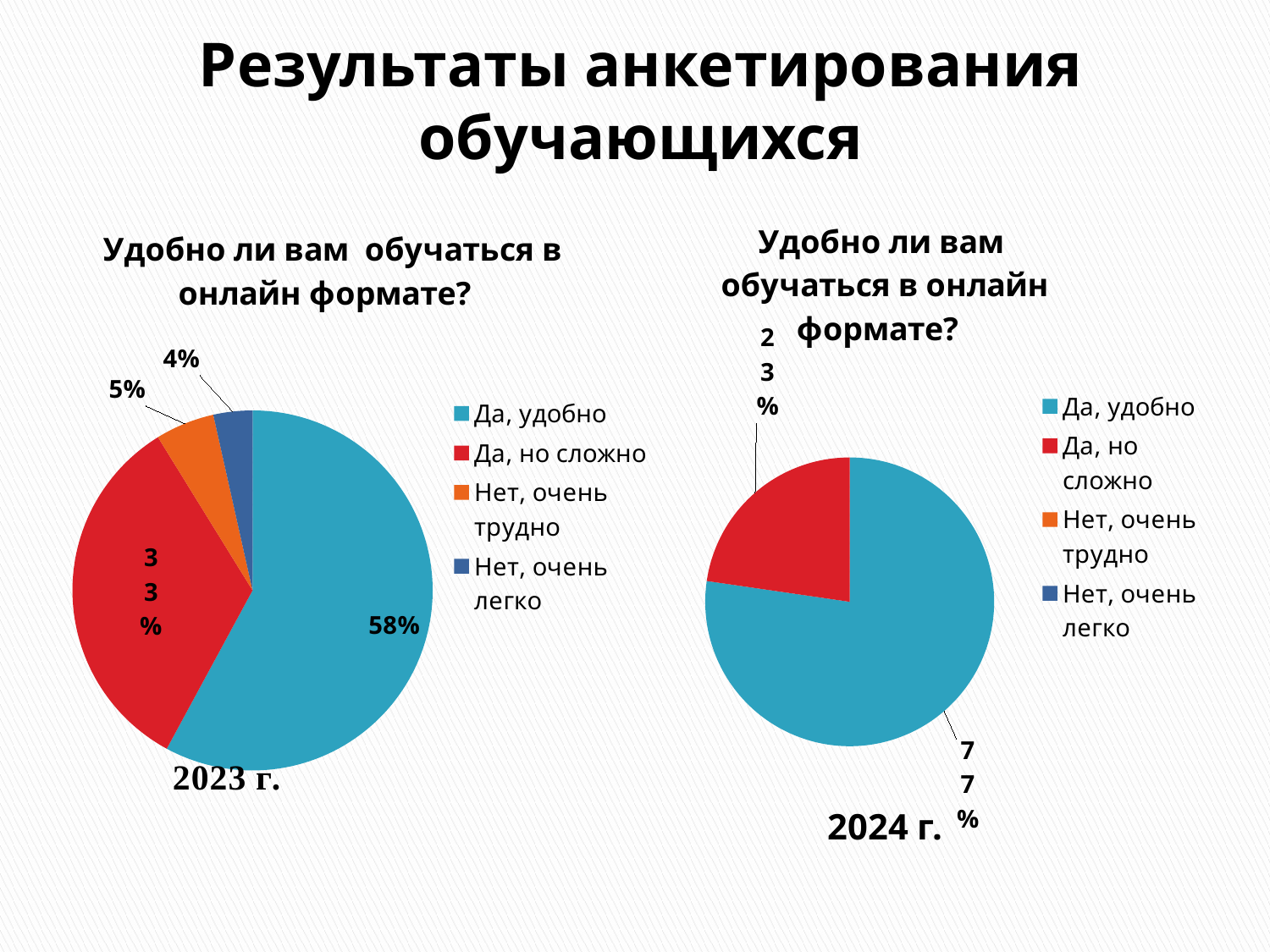
In the 2023 pie chart, what share of respondents answered "Нет, очень трудно"? 5% In the 2023 pie chart, what share of respondents answered "Нет, очень легко"? 4% How many entries does the legend of the 2024 chart list? 4 What is the difference between the "Да, удобно" share in 2024 and in 2023? 19% In the 2023 pie chart, which answer has the largest share? Да, удобно In the 2023 pie chart, what share of respondents answered "Да, удобно"? 58% What type of chart is used on this slide? Pie chart In the 2023 pie chart, which answer has the smallest share? Нет, очень легко In the 2024 pie chart, what share of respondents answered "Да, удобно"? 77% In the 2024 pie chart, what share of respondents answered "Да, но сложно"? 23% In the 2023 pie chart, what share of respondents answered "Да, но сложно"? 33% In the 2023 pie chart, what is the difference between the "Да, удобно" and "Да, но сложно" shares? 25%